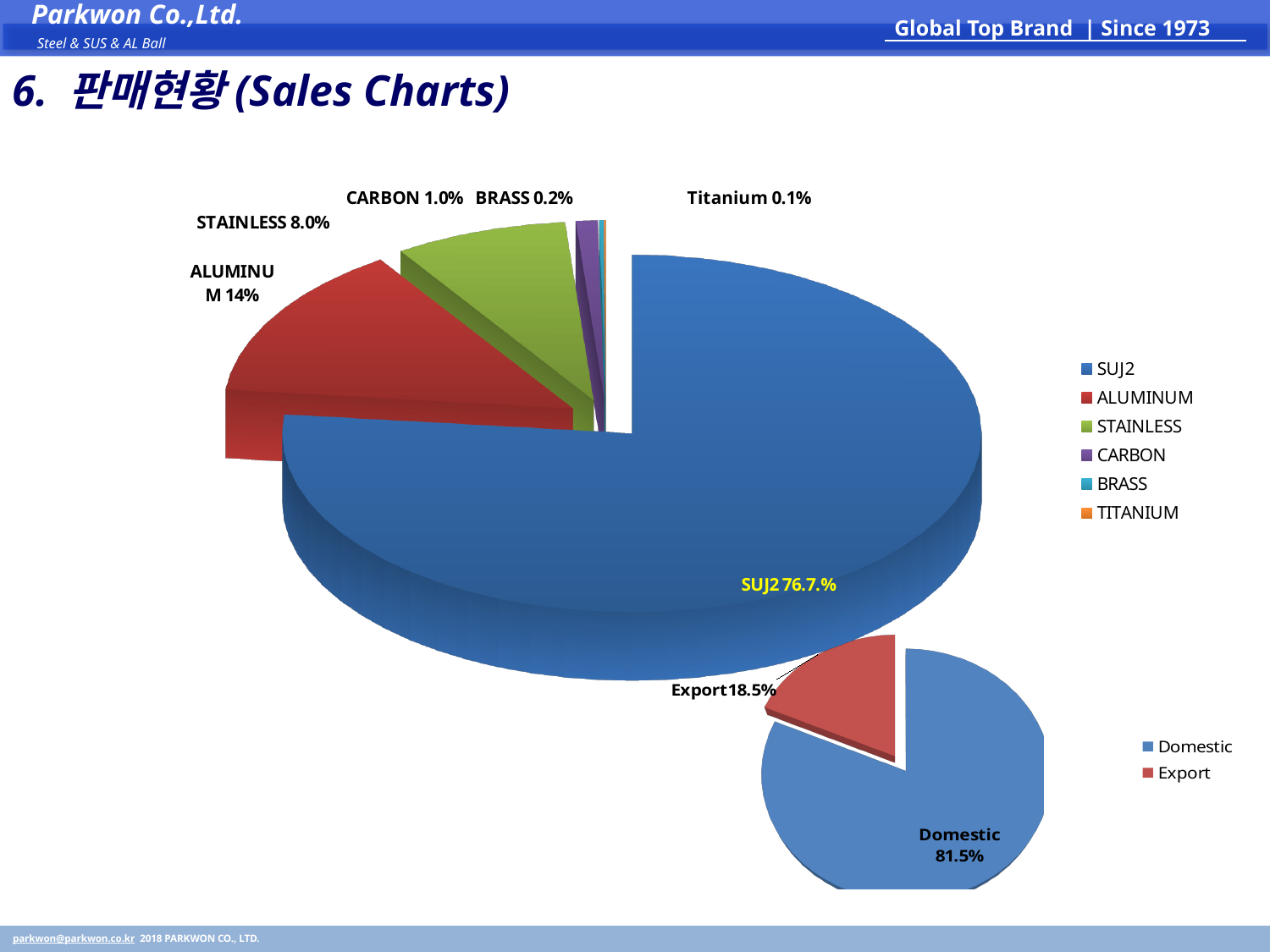
In the large pie chart of sales by material, what share does Titanium have? 0.1% In the large pie chart of sales by material, what share does STAINLESS have? 8.0% In the large pie chart of sales by material, which is larger, ALUMINUM or STAINLESS? ALUMINUM What kind of chart is the small chart at the bottom right showing Domestic and Export? Pie chart In the large pie chart of sales by material, which material has the smallest slice? TITANIUM In the small Domestic/Export pie chart, what is the difference between the Domestic and Export shares? 63.0% In the large pie chart of sales by material, what share does ALUMINUM have? 14% How many entries does the legend of the large pie chart of sales by material list? 6 In the large pie chart of sales by material, which material has the largest slice? SUJ2